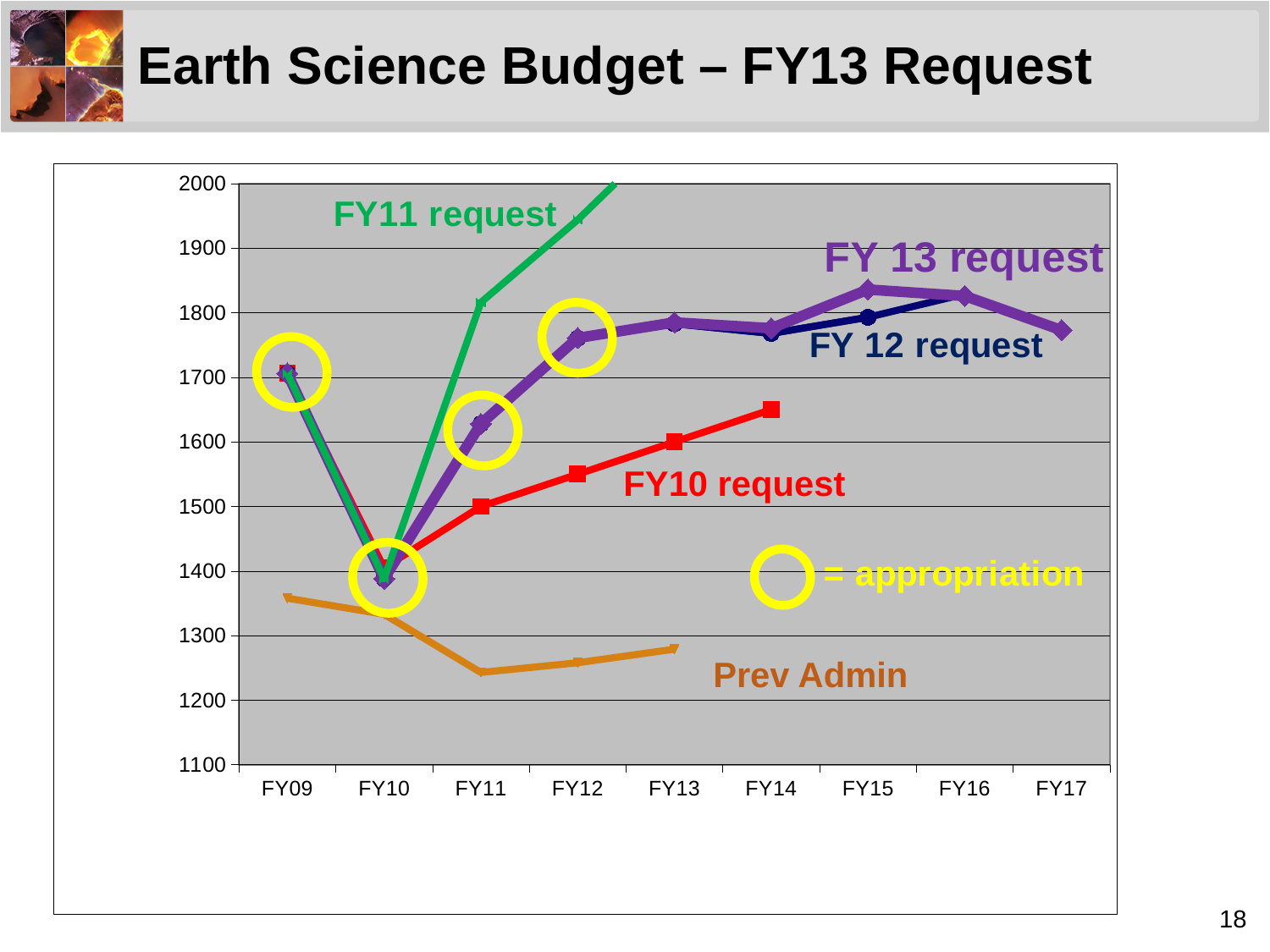
Is the value of the FY11 request line at FY11 greater or less than 1700? greater Does the Prev Admin line rise or fall from FY09 to FY11? fall At FY13, which is larger: the FY10 request or the FY 13 request? FY 13 request What kind of chart is shown on the slide? line chart How many fiscal years are labelled along the x axis? 9 Which series has the lowest value at FY13? Prev Admin How many budget series are labelled on the chart? 5 Is the value of the FY 13 request line at FY15 greater or less than 1800? greater At FY11, which is larger: the FY11 request or the FY 13 request? FY11 request Is the value of the FY10 request line at FY14 greater or less than 1600? greater According to the chart's key, what do the yellow circles indicate? appropriation